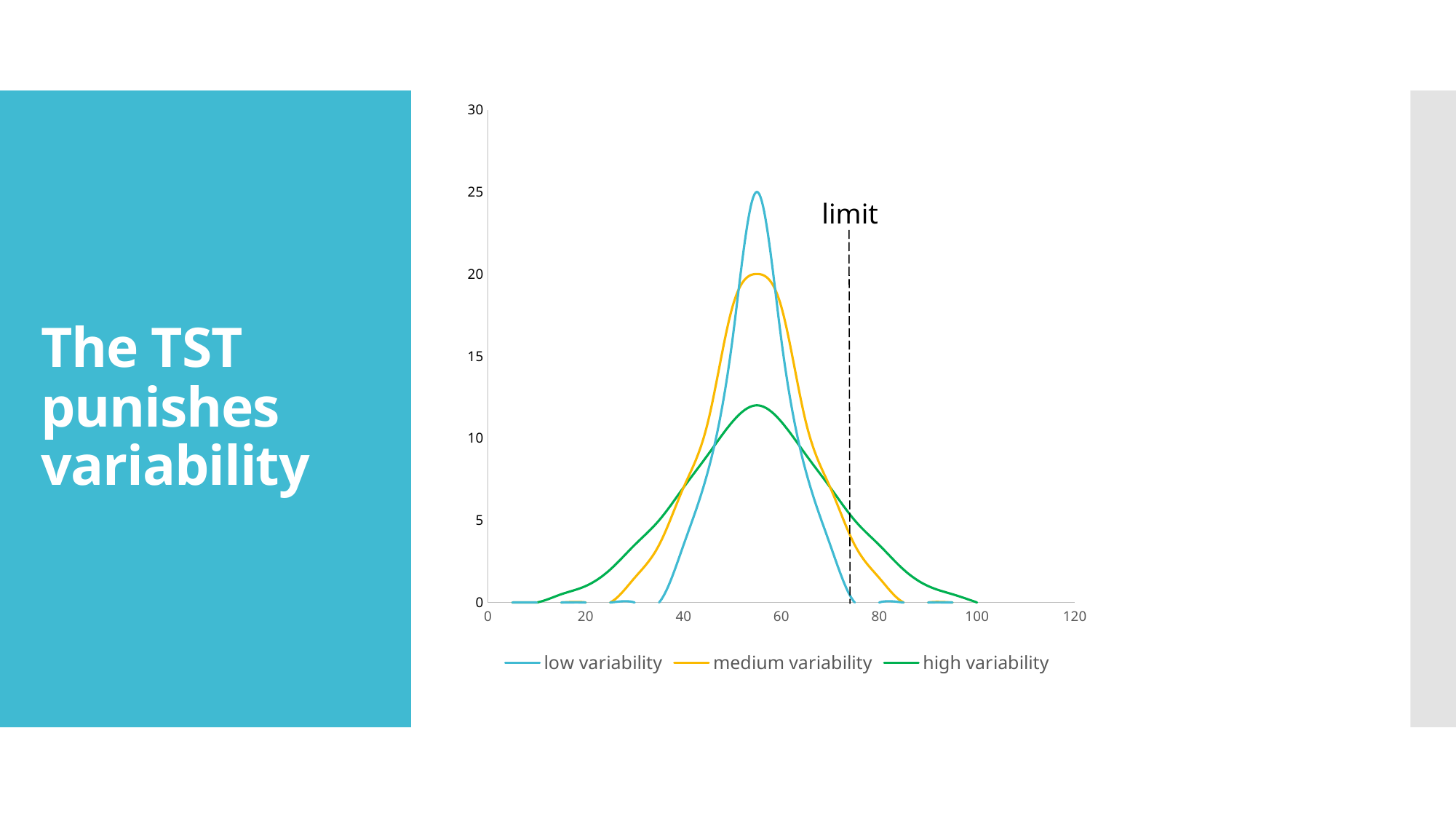
What is the peak value of the low variability curve? 25 What kind of chart is shown on the slide? line chart What is the peak value of the medium variability curve? 20 Is the peak of the high variability curve greater or less than 15? less What label is written next to the dashed vertical line? limit How many series does the legend list? 3 Is the peak of the high variability curve greater or less than 10? greater Does the low variability curve rise or fall between x = 40 and x = 55? rise What colour is the high variability line? green At x = 40, which curve is higher: low variability or high variability? high variability Which series reaches the highest peak? low variability Which series has the lowest peak? high variability